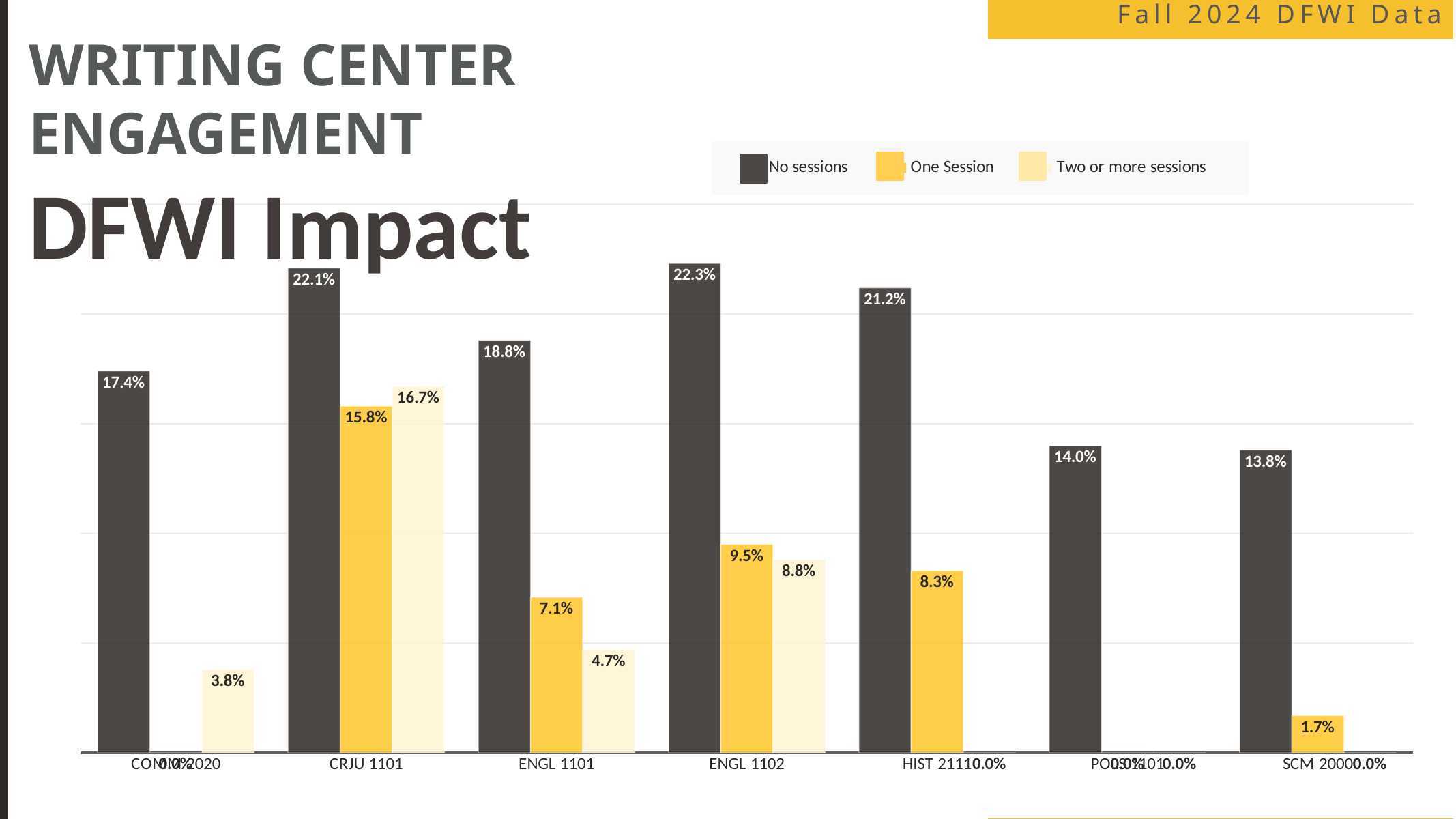
What is the Two or more sessions value for ENGL 1101? 4.7% Which course has the lowest No sessions value? SCM 2000 What is the No sessions value for ENGL 1102? 22.3% What kind of chart is shown on the slide? Bar chart For CRJU 1101, which is larger: the One Session value or the Two or more sessions value? Two or more sessions What is the difference between the No sessions and One Session values for ENGL 1101? 11.7% How many series does the legend list? 3 Which course has the highest No sessions value? ENGL 1102 What is the One Session value for HIST 2111? 8.3% Which series is shown in dark grey in the legend? No sessions How many courses are shown on the x axis? 7 What is the One Session value for CRJU 1101? 15.8%